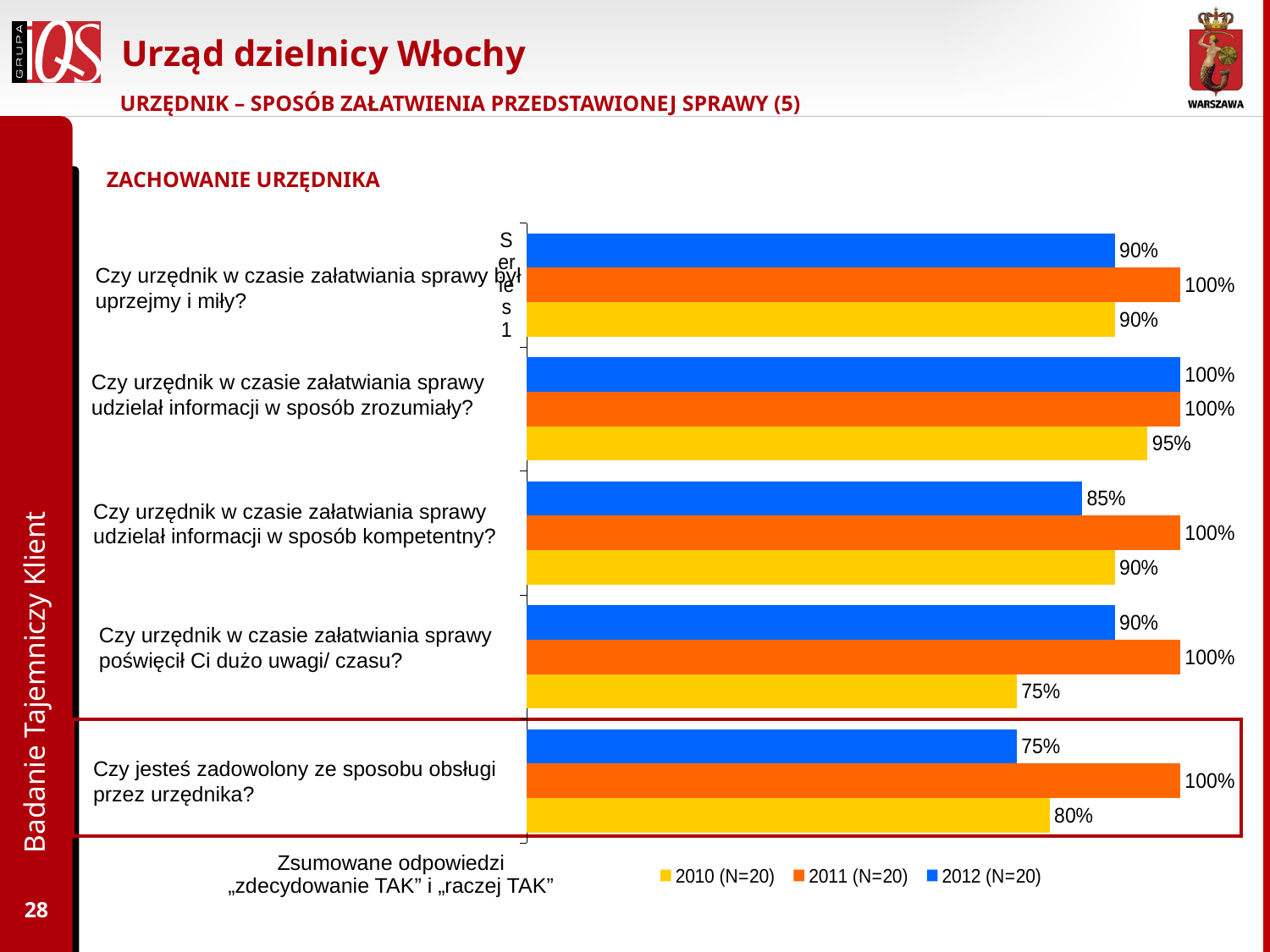
What type of chart is shown on the slide? bar chart What is the 2011 (N=20) value for "Czy urzędnik w czasie załatwiania sprawy był uprzejmy i miły?"? 100% How many question categories are plotted on the chart? 5 What is the 2012 (N=20) value for "Czy jesteś zadowolony ze sposobu obsługi przez urzędnika?"? 75% Which year has the lowest value for "Czy urzędnik w czasie załatwiania sprawy poświęcił Ci dużo uwagi/ czasu?"? 2010 (N=20) How many series does the legend list? 3 What is the 2012 (N=20) value for "Czy urzędnik w czasie załatwiania sprawy udzielał informacji w sposób kompetentny?"? 85% What is the difference between the 2011 (N=20) and 2012 (N=20) values for "Czy jesteś zadowolony ze sposobu obsługi przez urzędnika?"? 25% What is the 2010 (N=20) value for "Czy urzędnik w czasie załatwiania sprawy udzielał informacji w sposób zrozumiały?"? 95% For "Czy urzędnik w czasie załatwiania sprawy udzielał informacji w sposób kompetentny?", which is larger: the 2010 (N=20) value or the 2012 (N=20) value? 2010 (N=20) What is the 2010 (N=20) value for "Czy urzędnik w czasie załatwiania sprawy poświęcił Ci dużo uwagi/ czasu?"? 75% Which series is shown in orange in the legend? 2011 (N=20)